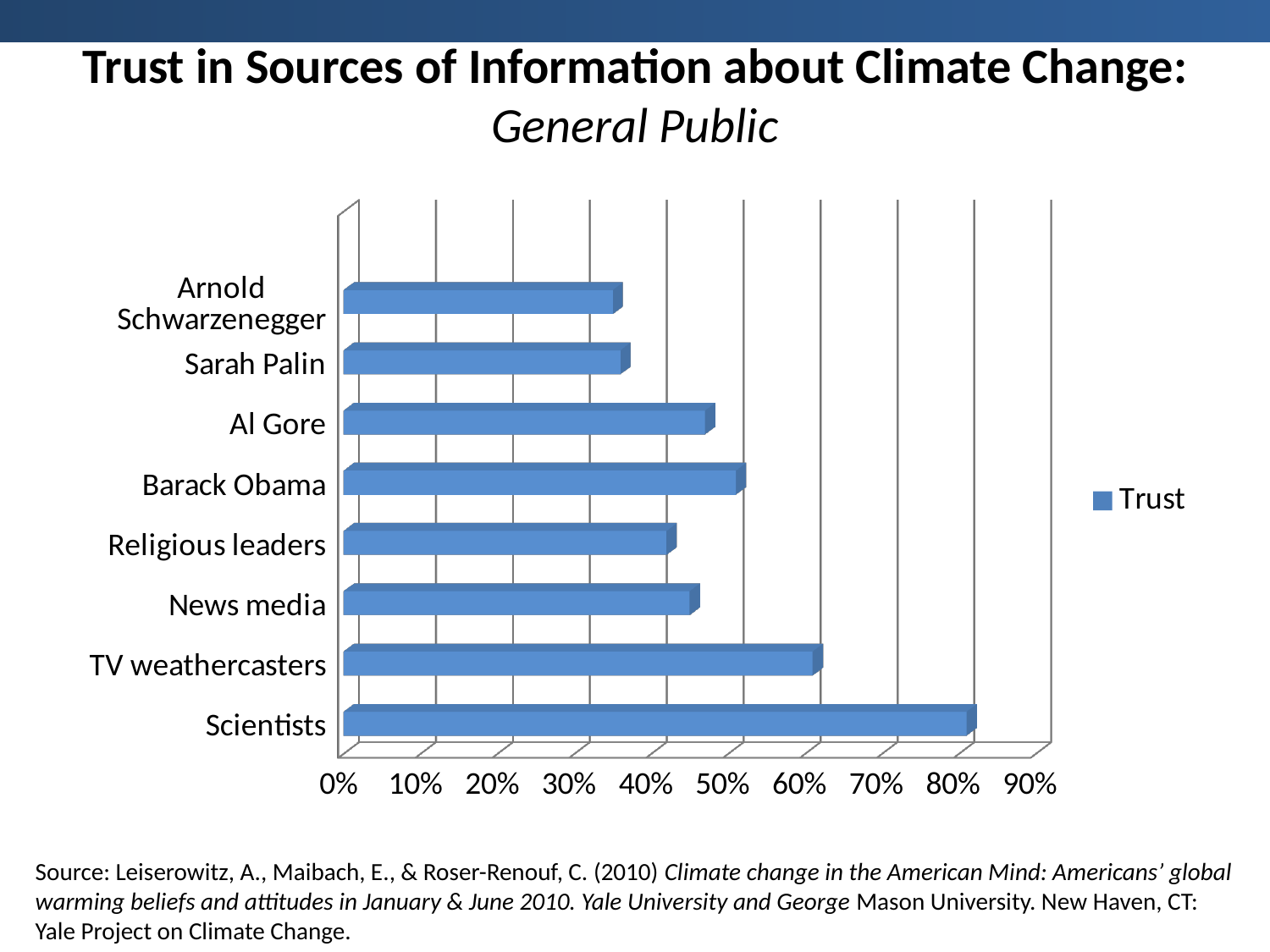
Which has a larger value, Scientists or Al Gore? Scientists Is the value for Sarah Palin greater or less than 40%? less How many series does the legend list? 1 Is the value for Scientists greater or less than 70%? greater Which source has the highest trust value? Scientists Is the value for TV weathercasters greater or less than 50%? greater What kind of chart is shown on the slide? bar chart Which has a larger value, TV weathercasters or News media? TV weathercasters How many sources of information are listed on the chart? 8 What is the name of the series shown in the legend? Trust